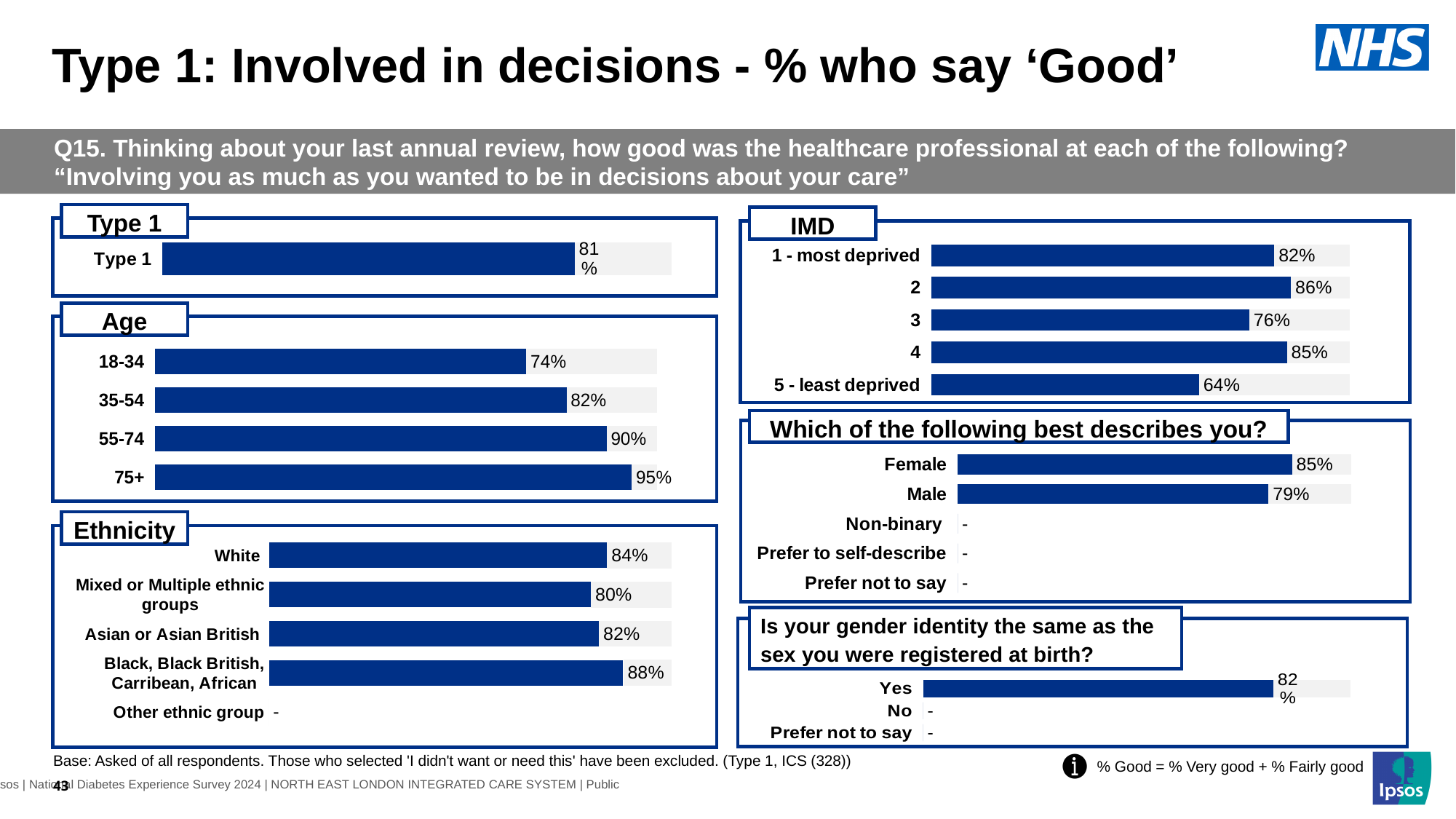
How many age groups are shown in the Age chart? 4 In the IMD chart, which category has the highest value? 2 In the Ethnicity chart, what is the value for 'Black, Black British, Carribean, African'? 88% In the Ethnicity chart, which is larger: the value for White or the value for Mixed or Multiple ethnic groups? White In the 'Is your gender identity the same as the sex you were registered at birth?' chart, what is the value for Yes? 82% In the 'Which of the following best describes you?' chart, what is the difference between the Female and Male values? 6% What type of chart is used in the IMD section? Bar chart In the Age chart, what is the value for the 75+ age group? 95% In the 'Which of the following best describes you?' chart, what is the value for Male? 79% In the Age chart, which age group has the lowest value? 18-34 In the IMD chart, what is the difference between the values for '2' and '5 - least deprived'? 22% In the IMD chart, what is the value for '5 - least deprived'? 64%